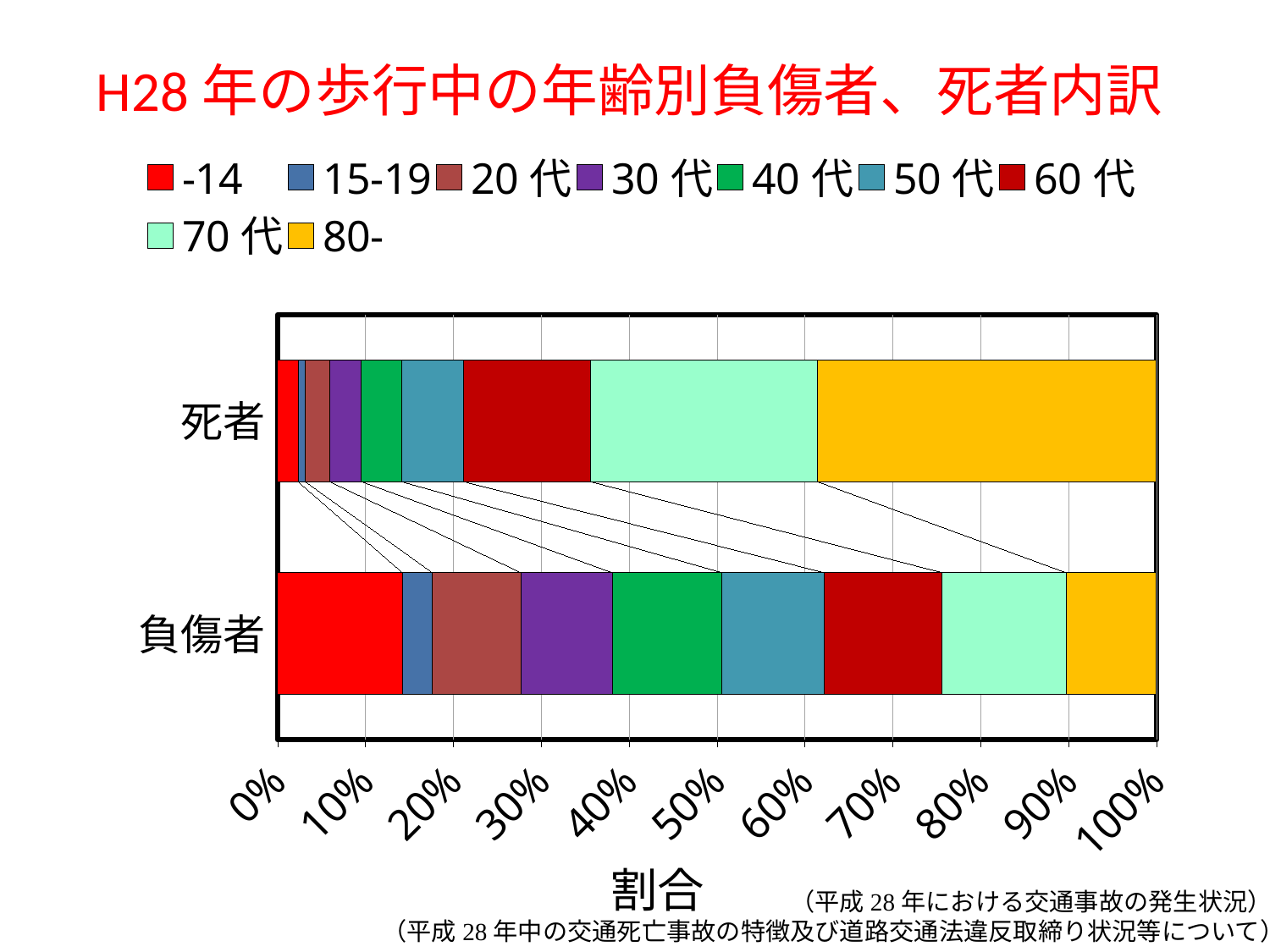
Is the -14 share larger in the 死者 bar or the 負傷者 bar? 負傷者 Is the 80- share larger in the 死者 bar or the 負傷者 bar? 死者 How many series does the legend list? 9 What is the label of the x axis? 割合 What is the title of the chart on the slide? H28年の歩行中の年齢別負傷者、死者内訳 Which age group has the smallest segment in the 死者 bar? 15-19 Is the 80- segment in the 死者 bar greater or less than 30%? greater Which age group has the smallest segment in the 負傷者 bar? 15-19 How many categories (bars) does the chart show? 2 Is the -14 segment in the 負傷者 bar greater or less than 10%? greater Which age group has the largest segment in the 死者 bar? 80- What kind of chart is shown on the slide? Stacked bar chart